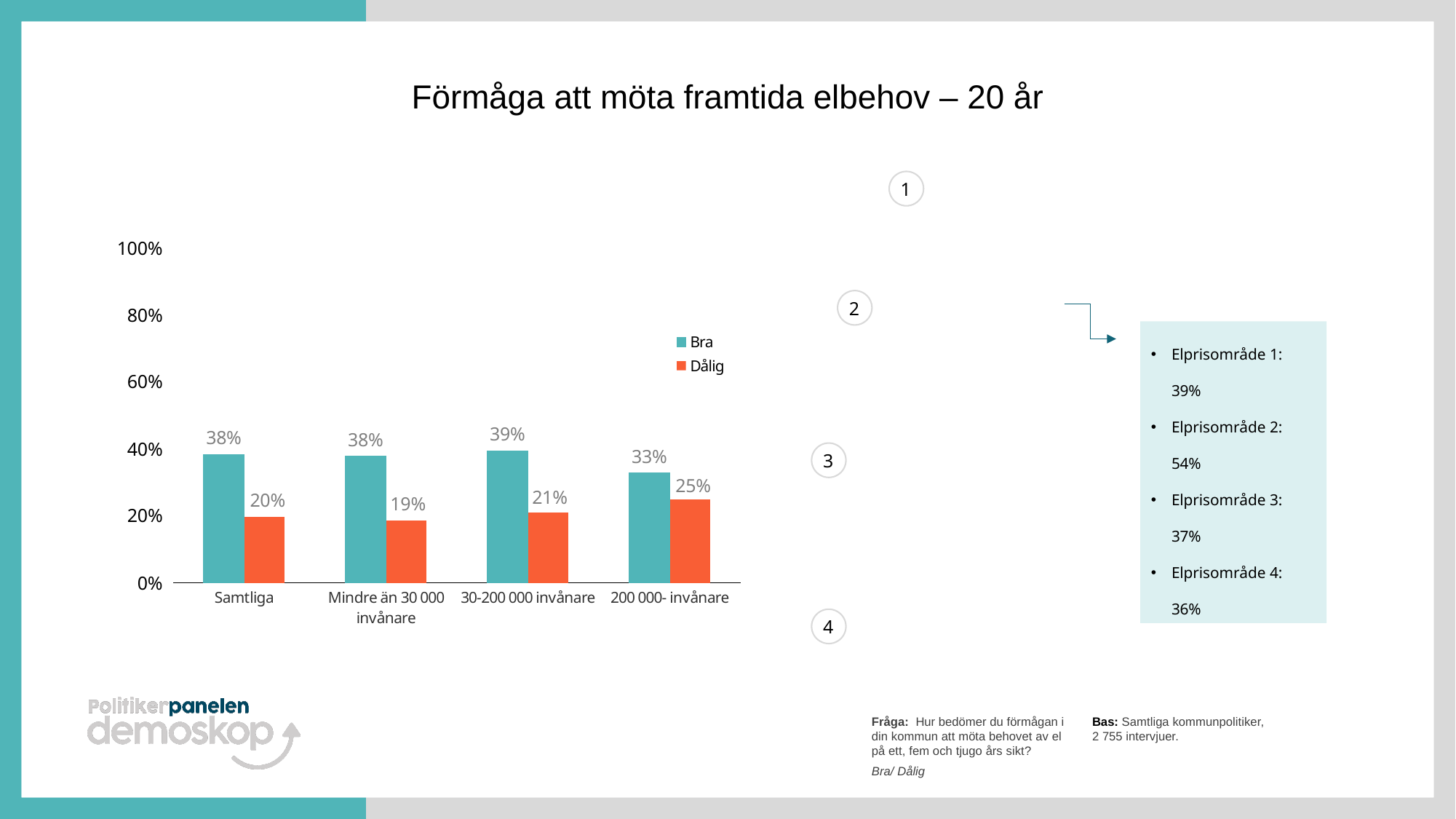
What is the difference between Bra and Dålig for 30-200 000 invånare? 18 percentage points What is the title of the chart? Förmåga att möta framtida elbehov – 20 år What kind of chart is shown on the slide? Bar chart Which is larger for Samtliga, Bra or Dålig? Bra What is the value of Dålig for 200 000- invånare? 25% What is the value of Dålig for Mindre än 30 000 invånare? 19% How many categories are shown on the x axis? 4 What is the value of Bra for Samtliga? 38% Which category has the lowest Bra value? 200 000- invånare Which category has the highest Bra value? 30-200 000 invånare How many series does the legend list? 2 Which category has the lowest Dålig value? Mindre än 30 000 invånare